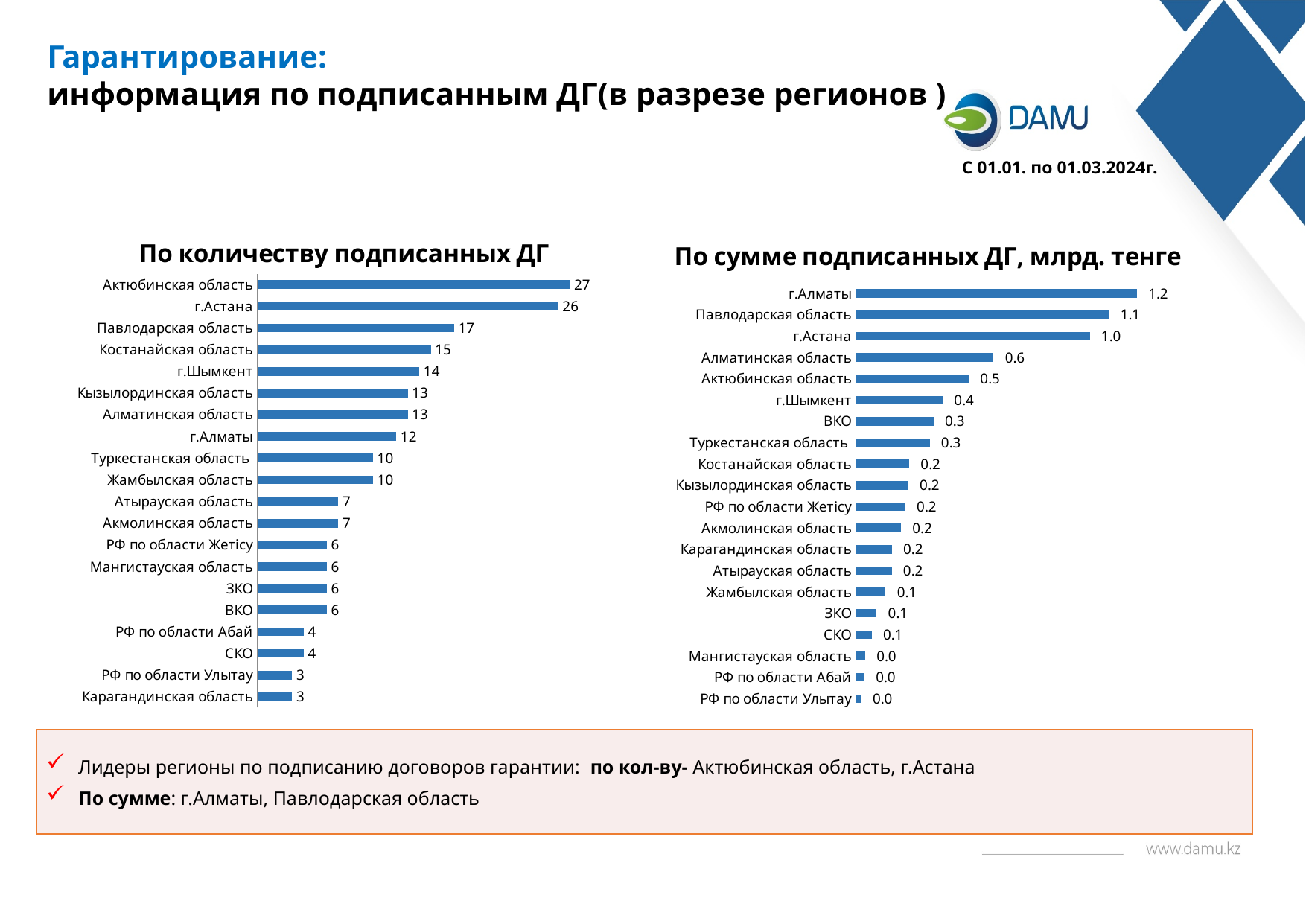
In the chart 'По сумме подписанных ДГ, млрд. тенге', which region has the highest value? г.Алматы In the chart 'По сумме подписанных ДГ, млрд. тенге', what is the value for Туркестанская область? 0.3 In the chart 'По количеству подписанных ДГ', which region has the highest value? Актюбинская область In the chart 'По количеству подписанных ДГ', what is the value for Павлодарская область? 17 In the chart 'По количеству подписанных ДГ', which is larger: г.Шымкент or г.Алматы? г.Шымкент In the chart 'По сумме подписанных ДГ, млрд. тенге', what is the value for г.Астана? 1.0 In the chart 'По количеству подписанных ДГ', what is the value for Карагандинская область? 3 In the chart 'По сумме подписанных ДГ, млрд. тенге', what is the difference between г.Алматы and Алматинская область? 0.6 In the chart 'По количеству подписанных ДГ', how many regions are shown? 20 In the chart 'По сумме подписанных ДГ, млрд. тенге', which is larger: Актюбинская область or г.Шымкент? Актюбинская область What type of chart is 'По количеству подписанных ДГ'? Bar chart In the chart 'По количеству подписанных ДГ', what is the difference between Актюбинская область and г.Астана? 1